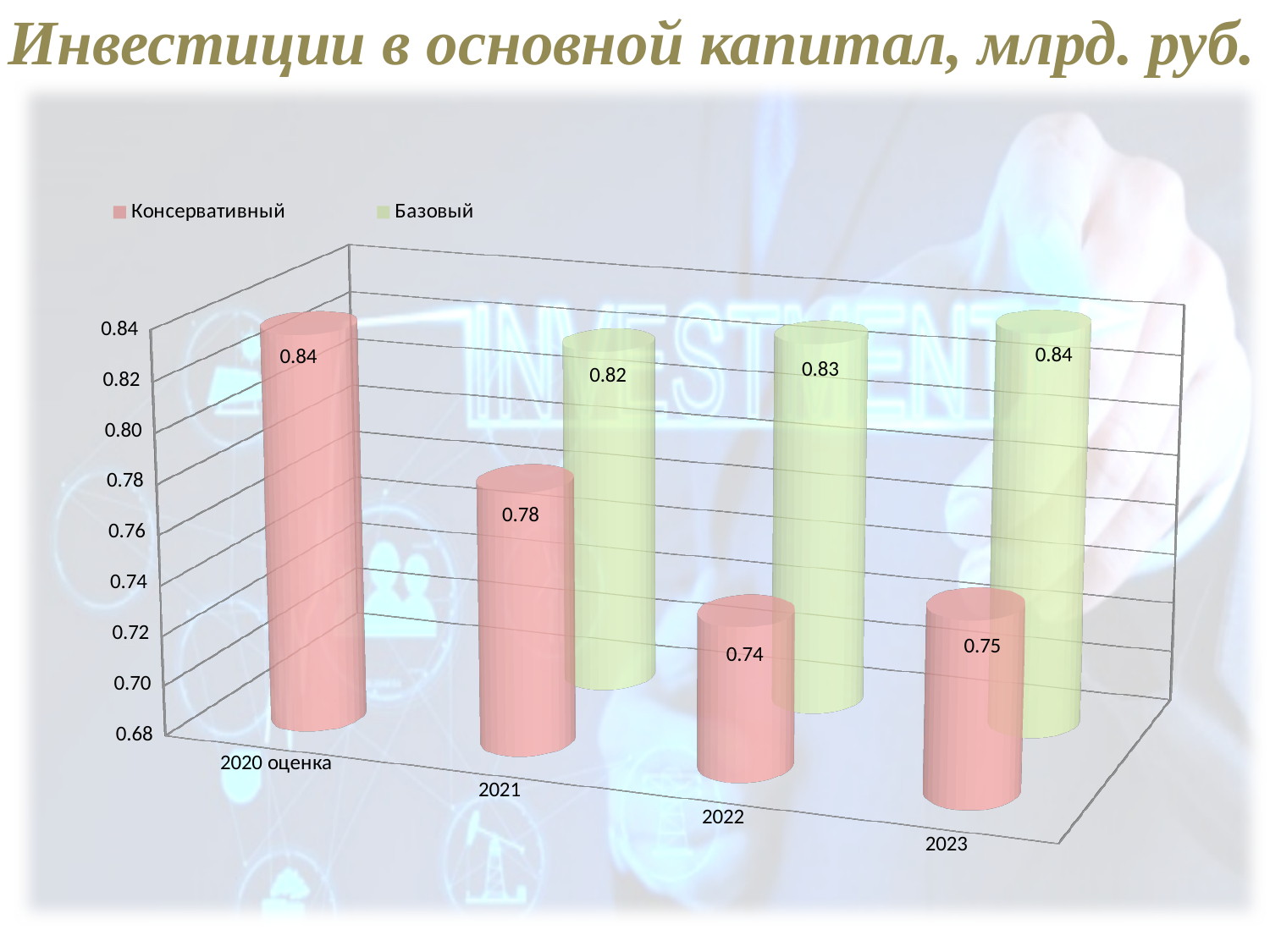
What is the value for Консервативный in 2023? 0.75 What is the value for Базовый in 2022? 0.83 How many categories are shown on the x axis? 4 In which year is the Консервативный series lowest? 2022 What is the value for Консервативный in 2021? 0.78 What is the difference between the Базовый and Консервативный values in 2022? 0.09 What is the title of the chart? Инвестиции в основной капитал, млрд. руб. How many series does the legend list? 2 Does the Базовый series rise or fall from 2021 to 2023? Rise What kind of chart is shown on the slide? Bar chart Which series has the larger value in 2023, Консервативный or Базовый? Базовый In which year is the Базовый series highest? 2023